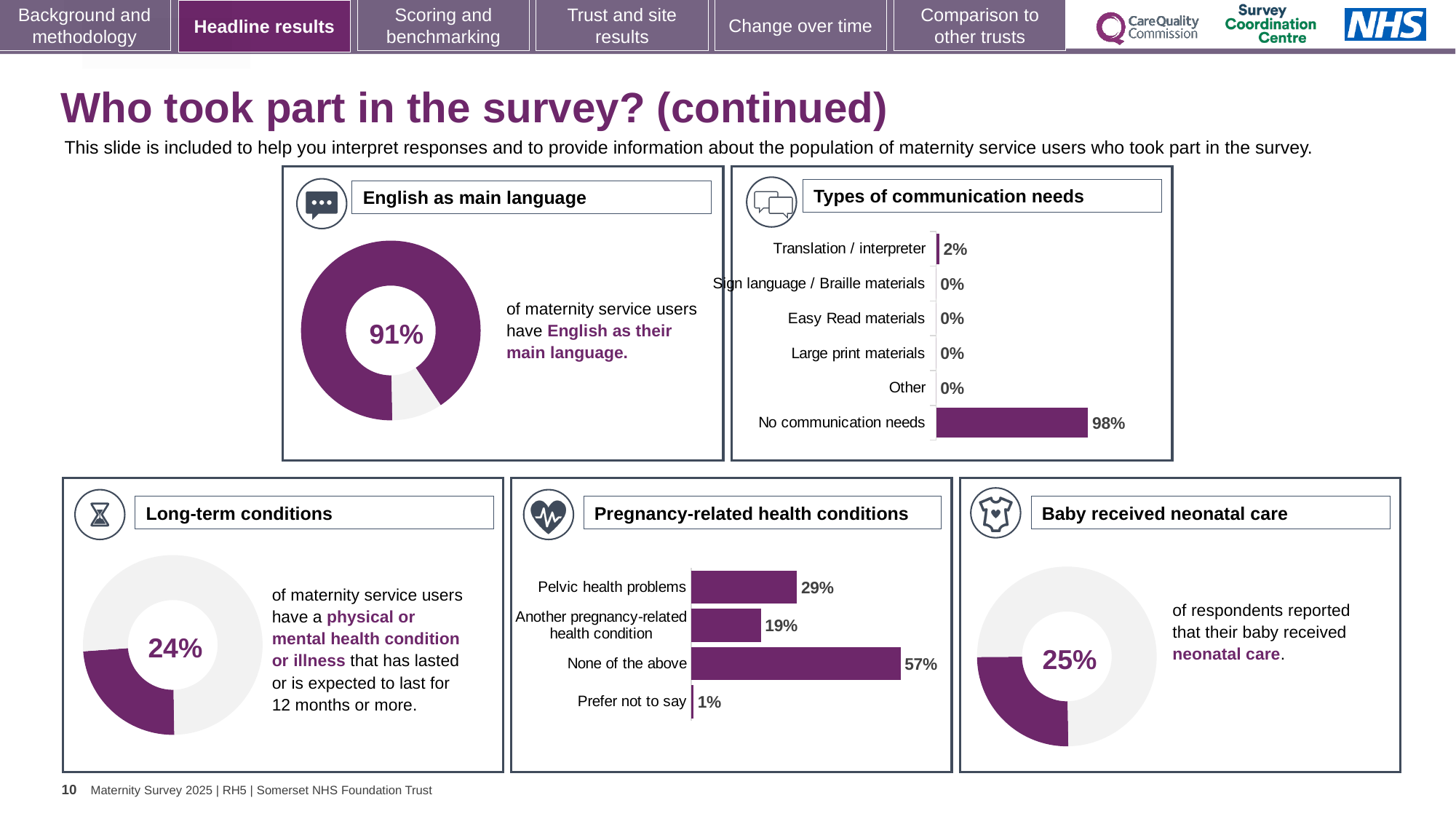
What kind of chart is the 'Pregnancy-related health conditions' chart? Bar chart In the 'Pregnancy-related health conditions' chart, which category has the lowest value? Prefer not to say In the 'Types of communication needs' chart, what is the value for 'No communication needs'? 98% In the 'Pregnancy-related health conditions' chart, what is the value for 'Pelvic health problems'? 29% In the 'English as main language' chart, what percentage of maternity service users have English as their main language? 91% In the 'Long-term conditions' chart, what percentage of maternity service users have a physical or mental health condition or illness? 24% In the 'Baby received neonatal care' chart, what percentage of respondents reported that their baby received neonatal care? 25% In the 'Types of communication needs' chart, which category has the highest value? No communication needs In the 'Types of communication needs' chart, how many categories are shown? 6 In the 'Pregnancy-related health conditions' chart, what is the difference between 'Pelvic health problems' and 'Another pregnancy-related health condition'? 10% In the 'Pregnancy-related health conditions' chart, which category has the highest value? None of the above In the 'Types of communication needs' chart, what is the value for 'Translation / interpreter'? 2%